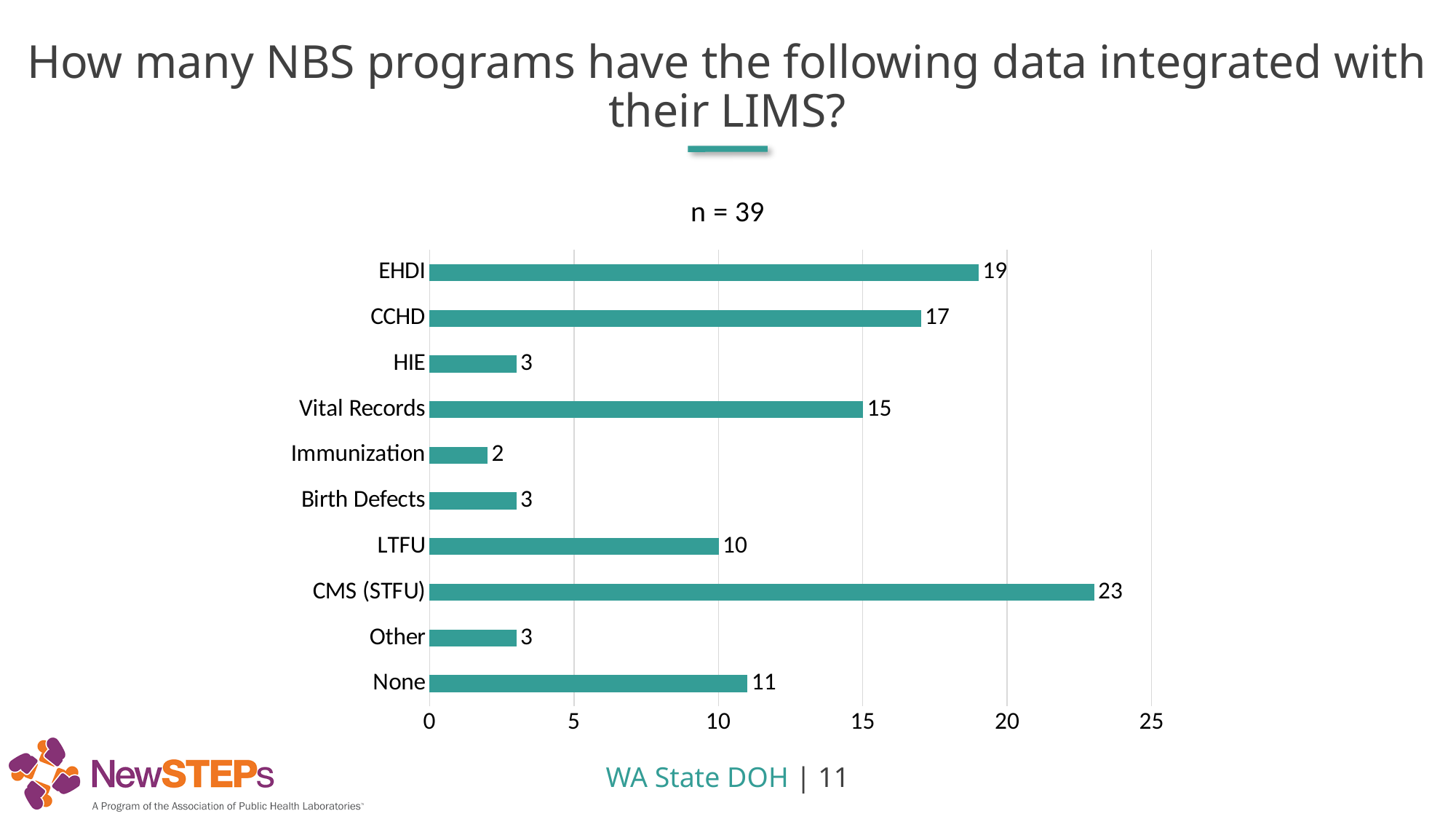
Which category has the highest value? CMS (STFU) Which is larger, the value for Vital Records or the value for None? Vital Records What is the difference between the values for CMS (STFU) and LTFU? 13 How many programs reported None? 11 What sample size (n) is shown above the chart? n = 39 What kind of chart is shown on the slide? Bar chart How many categories are shown in the chart? 10 What is the value for Vital Records? 15 What is the difference between the values for EHDI and CCHD? 2 Which category has the lowest value? Immunization What is the value for CMS (STFU)? 23 How many NBS programs have EHDI data integrated with their LIMS? 19